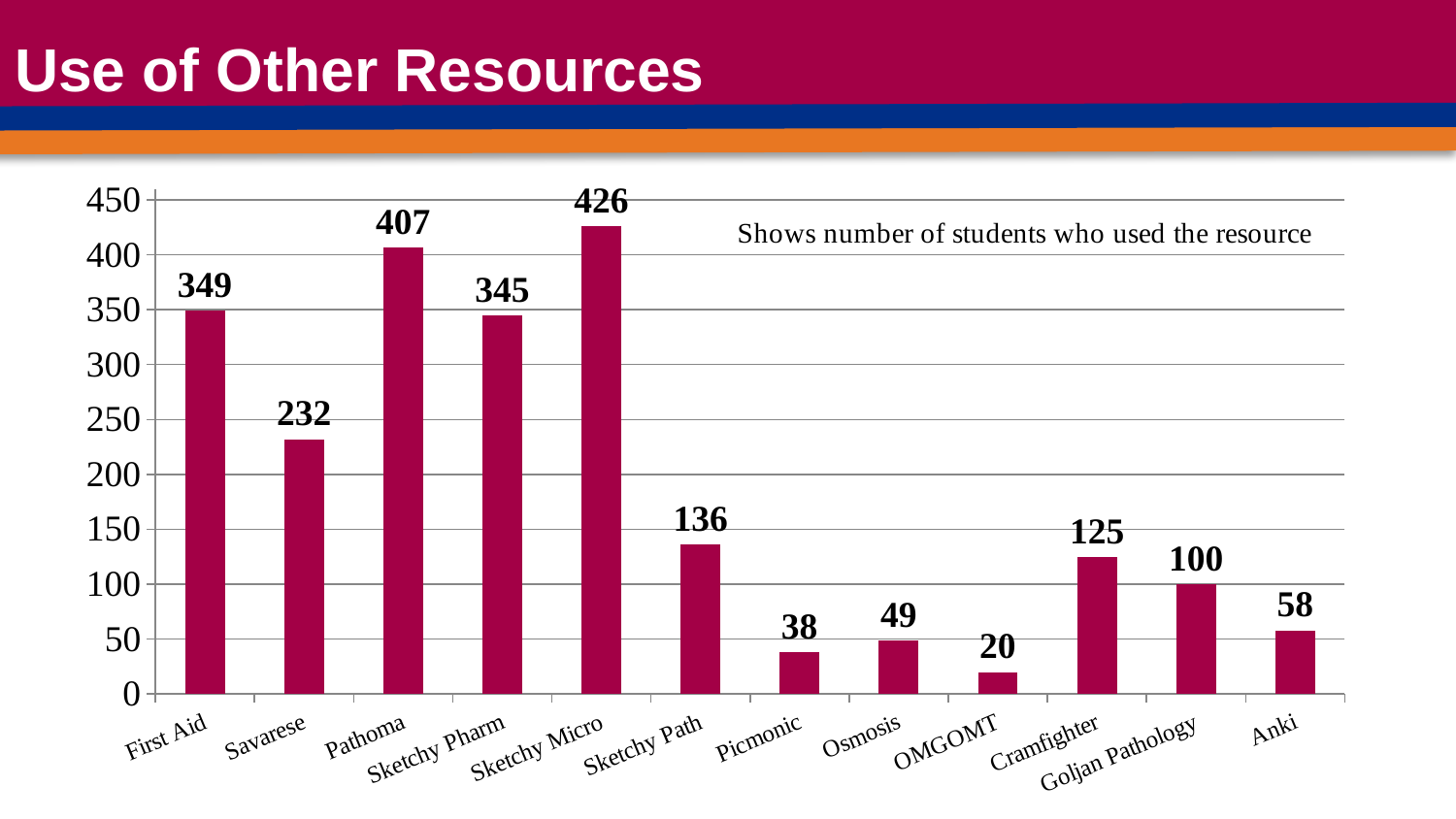
What is the title of the slide? Use of Other Resources According to the note on the chart, what do the values represent? Number of students who used the resource Which resource was used by more students, Cramfighter or Goljan Pathology? Cramfighter What kind of chart is shown on the slide? bar chart Which resource was used by the fewest students? OMGOMT Is the value for Savarese greater or less than 200? greater How many students used Pathoma? 407 What is the difference between the number of students who used Sketchy Path and the number who used Picmonic? 98 How many students used Osmosis? 49 What is the difference between the number of students who used Sketchy Micro and the number who used First Aid? 77 How many resources are shown on the chart? 12 Which resource was used by the most students? Sketchy Micro